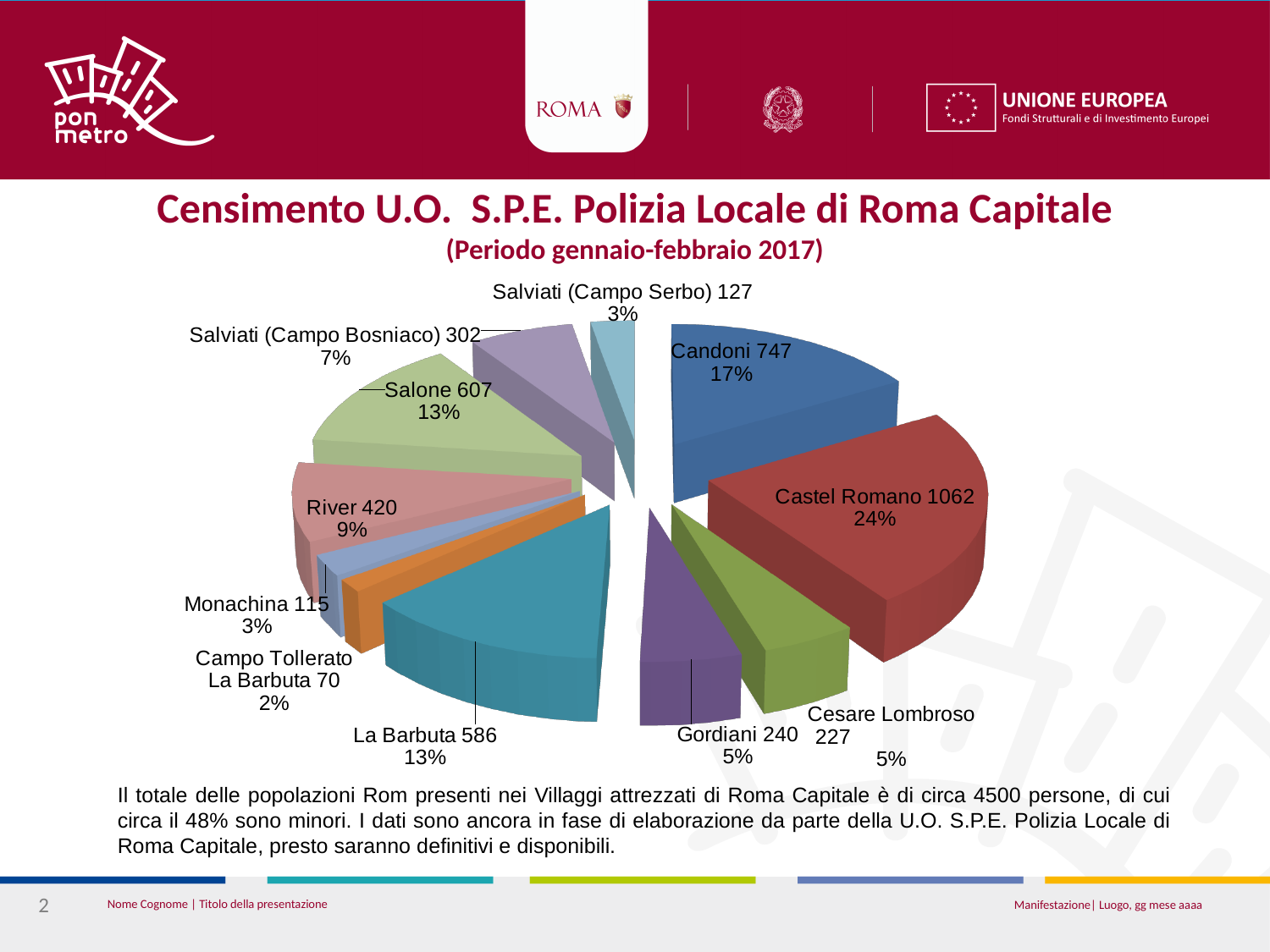
Which is larger, the value for Salone or the value for La Barbuta? Salone How many slices does the pie chart have? 11 Which category has the largest slice of the pie? Castel Romano Which category has the smallest slice of the pie? Campo Tollerato La Barbuta What is the value for River? 420 What is the difference between the values for Castel Romano and Candoni? 315 What is the title of the chart on the slide? Censimento U.O. S.P.E. Polizia Locale di Roma Capitale (Periodo gennaio-febbraio 2017) What percentage share does Salviati (Campo Bosniaco) have? 7% What is the value for Cesare Lombroso? 227 What is the value for Castel Romano? 1062 What percentage share does Candoni have in the pie chart? 17% What kind of chart is shown on the slide? pie chart